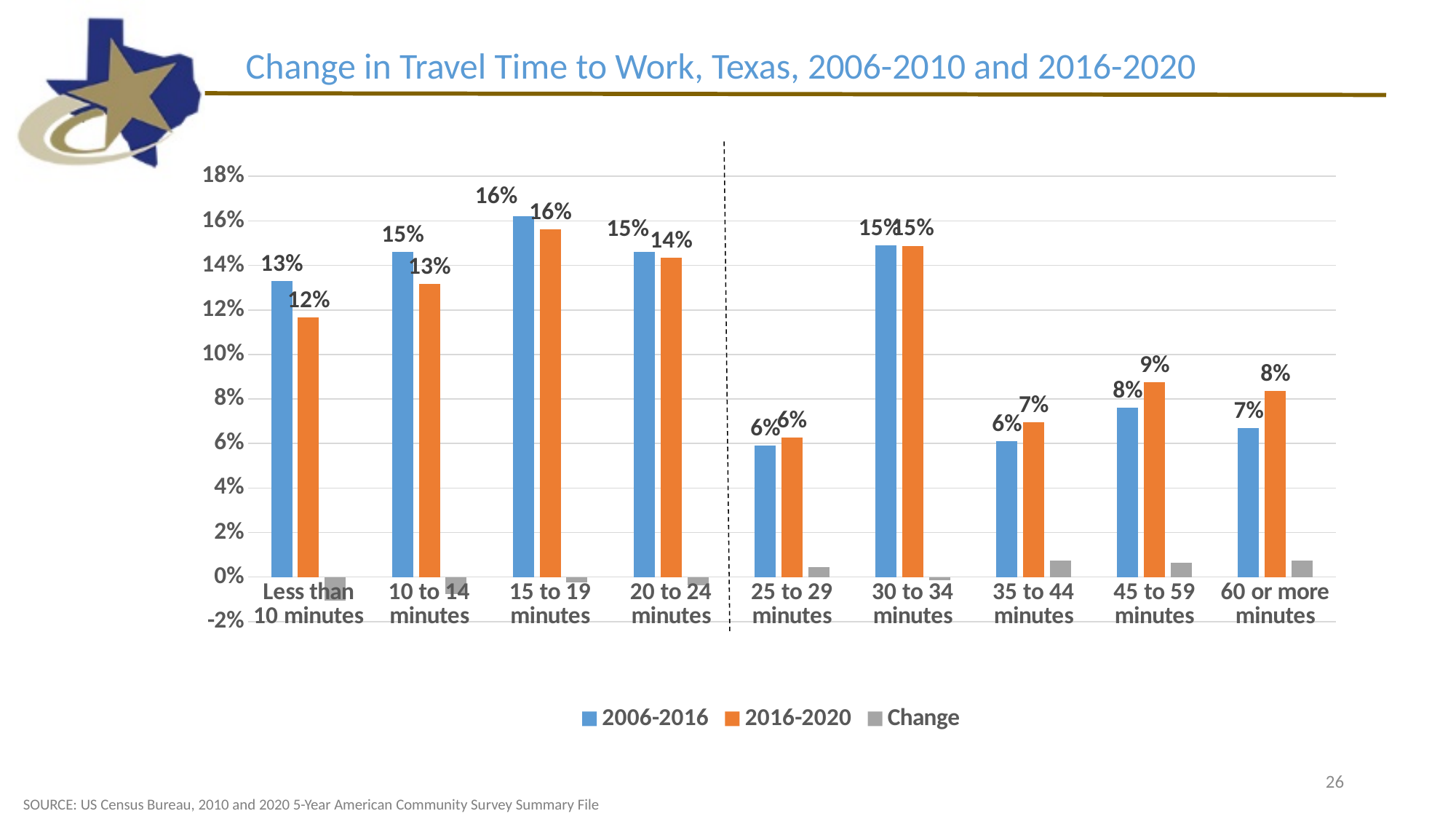
Which category has the highest 2006-2016 value? 15 to 19 minutes How many travel time categories are shown on the x axis? 9 What kind of chart is shown on the slide? bar chart What is the 2016-2020 value for the Less than 10 minutes category? 12% Which category has the lowest 2016-2020 value? 25 to 29 minutes What is the 2016-2020 value for the 45 to 59 minutes category? 9% How many series does the legend list? 3 What is the 2006-2016 value for the 10 to 14 minutes category? 15% Is the Change value for the 45 to 59 minutes category greater or less than 2%? less For the 45 to 59 minutes category, which series has the larger value, 2006-2016 or 2016-2020? 2016-2020 For the 10 to 14 minutes category, how much larger is the 2006-2016 value than the 2016-2020 value? 2% What is the title of the chart? Change in Travel Time to Work, Texas, 2006-2010 and 2016-2020